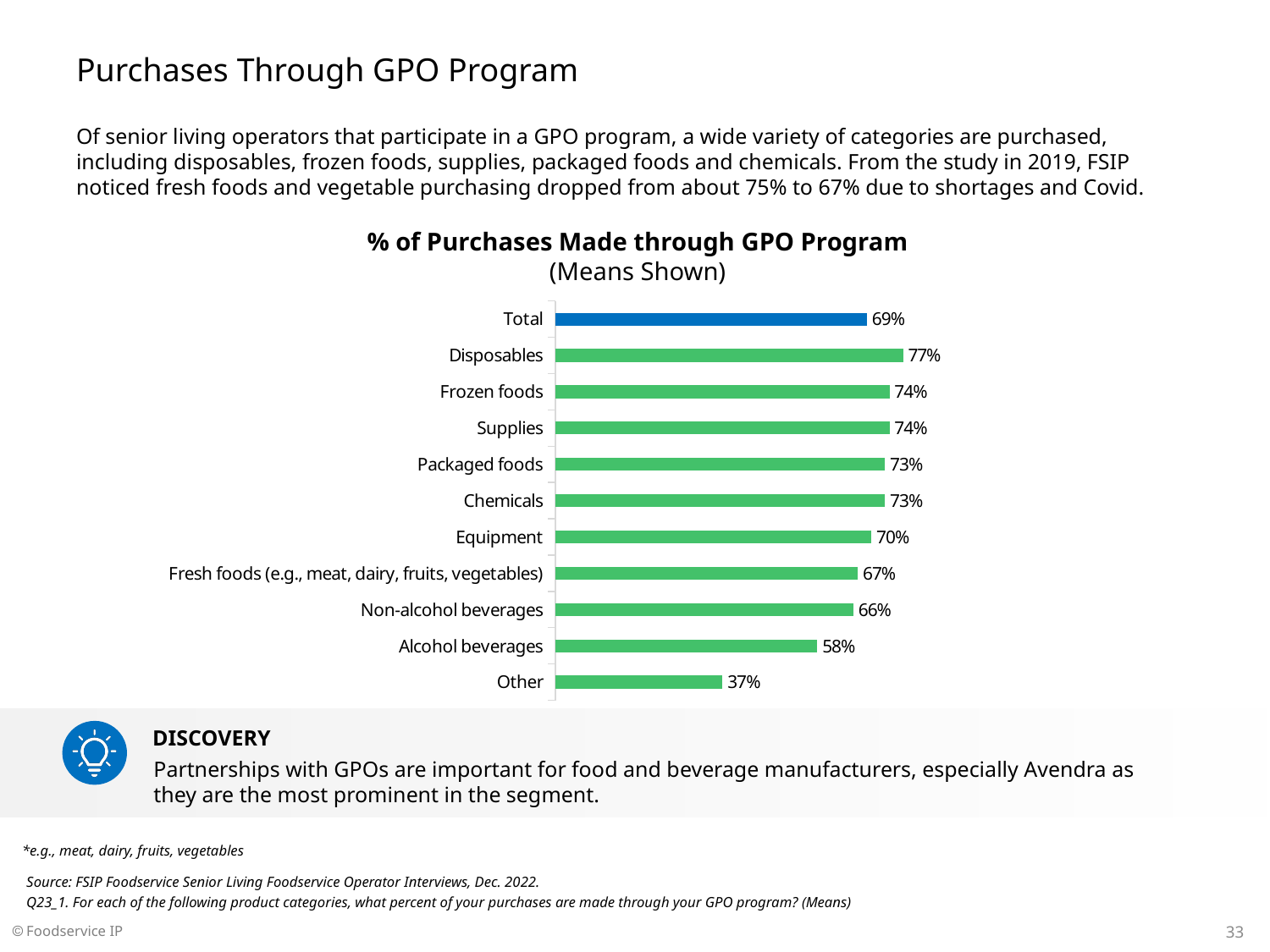
What is the value for Alcohol beverages? 58% What is the value for Disposables? 77% What is the difference between the values for Frozen foods and Non-alcohol beverages? 8% What is the value for Total? 69% What is the value for Equipment? 70% Which is larger, the value for Chemicals or the value for Alcohol beverages? Chemicals What is the title of the chart? % of Purchases Made through GPO Program Which category has the lowest value? Other What is the difference between the values for Disposables and Other? 40% What kind of chart is shown on the slide? Bar chart How many categories are shown in the chart? 11 Which category has the highest value? Disposables